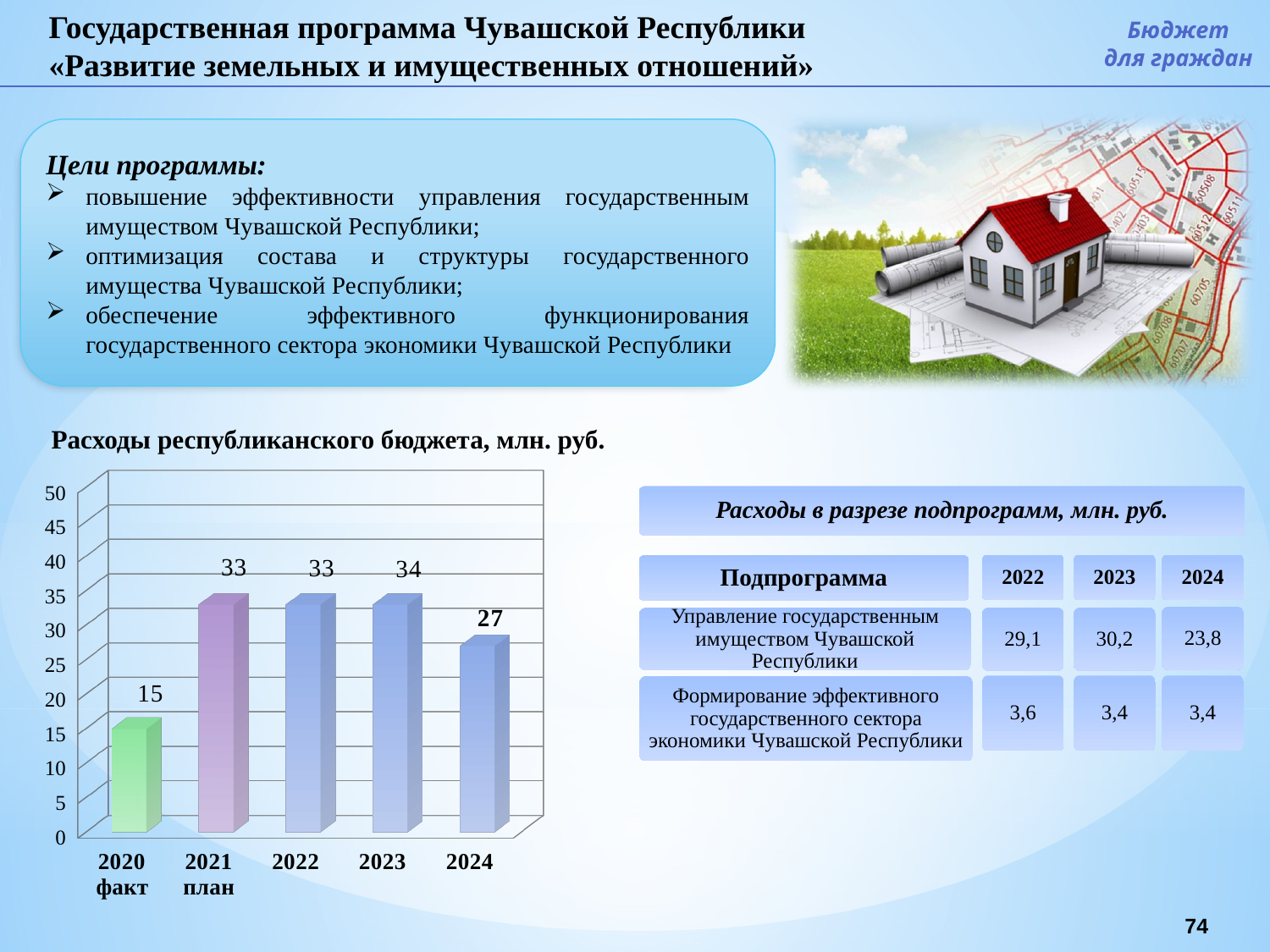
What kind of chart is shown on the slide? bar chart Is the value for 2024 greater or less than 30? less What is the difference between the values for 2021 план and 2020 факт? 18 What is the value for 2024 in the chart? 27 What is the title of the chart? Расходы республиканского бюджета, млн. руб. How many categories are shown on the x axis of the chart? 5 What is the difference between the values for 2023 and 2024? 7 Which category has the highest value in the chart? 2023 Which category has the lowest value in the chart? 2020 факт What is the value for 2023 in the chart? 34 What is the value for 2020 факт in the chart? 15 Which is larger, the value for 2022 or the value for 2024? 2022